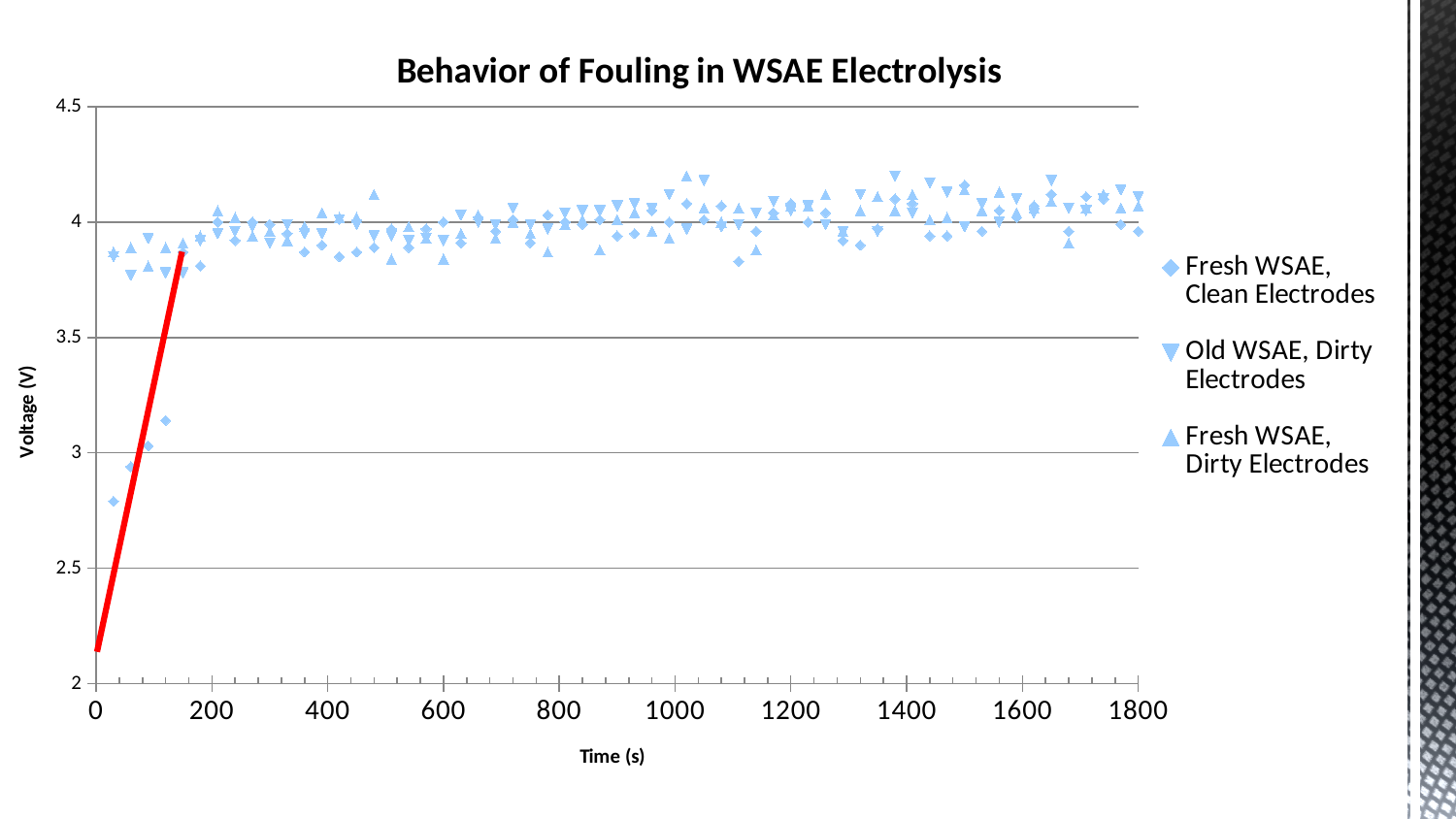
What is the title of the chart? Behavior of Fouling in WSAE Electrolysis What is the maximum time shown on the horizontal axis? 1800 Do the Fresh WSAE, Clean Electrodes values rise or fall over the first 200 seconds? rise Is the earliest Fresh WSAE, Clean Electrodes value (near 30 s) greater or less than 3? less What kind of chart is shown on the slide? Scatter chart Are the Old WSAE, Dirty Electrodes values at 1000 s greater or less than 3.5? greater What is the label of the horizontal axis? Time (s) How many series does the chart legend list? 3 Are the Fresh WSAE, Dirty Electrodes values at 1600 s greater or less than 3.5? greater